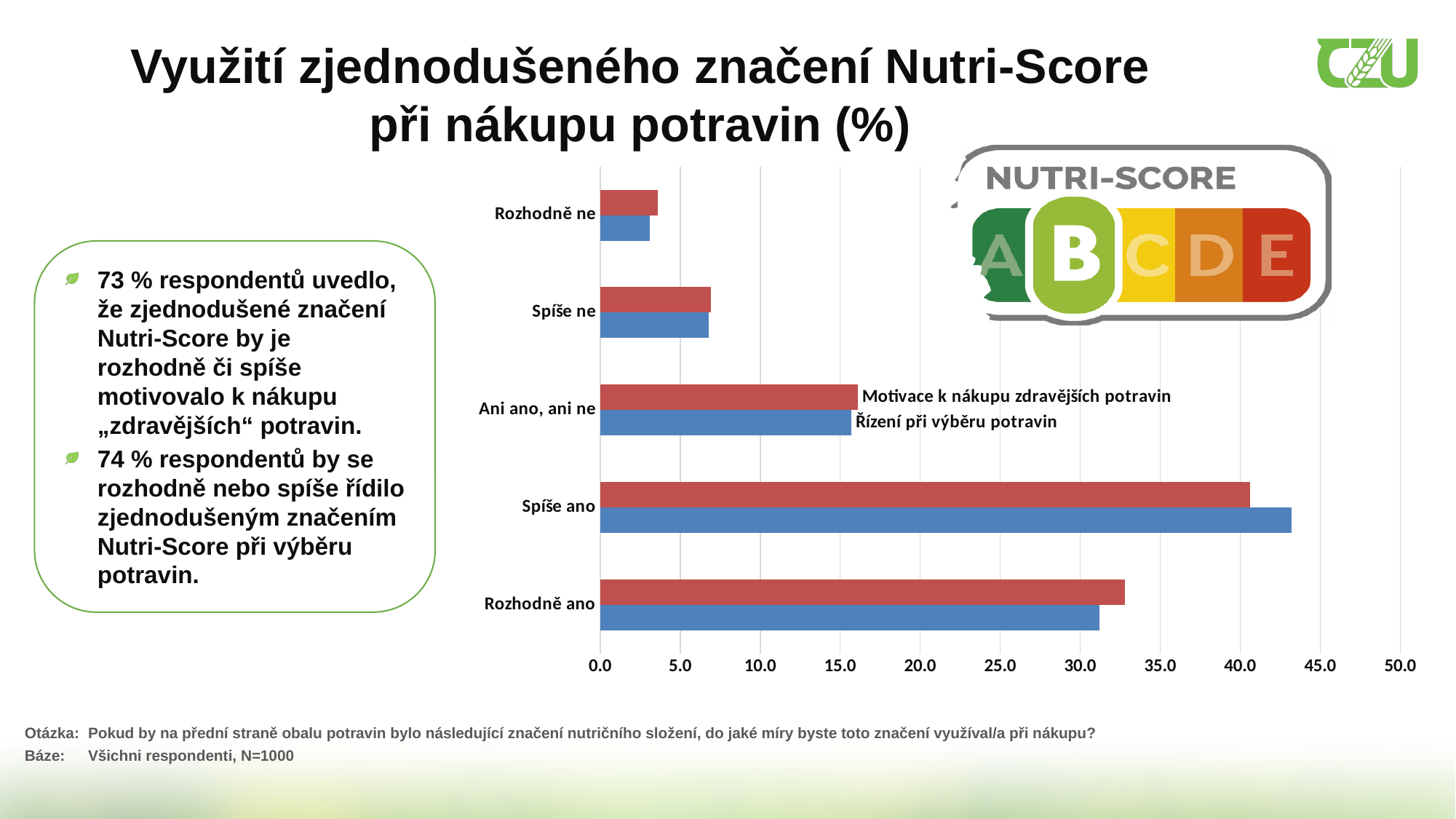
Is the value for "Ani ano, ani ne" in the series "Řízení při výběru potravin" greater or less than 20.0? less What kind of chart is shown on the slide? bar chart Is the value for "Rozhodně ano" in the series "Motivace k nákupu zdravějších potravin" greater or less than 30.0? greater How many categories are shown on the chart? 5 For the category "Spíše ano", which series has the larger value: "Motivace k nákupu zdravějších potravin" or "Řízení při výběru potravin"? Řízení při výběru potravin Which series is shown in blue on the chart? Řízení při výběru potravin Is the value for "Spíše ano" in the series "Řízení při výběru potravin" greater or less than 40.0? greater Which category has the highest value for the series "Motivace k nákupu zdravějších potravin"? Spíše ano What is the highest value shown on the chart's horizontal axis? 50.0 Which category has the lowest value for the series "Motivace k nákupu zdravějších potravin"? Rozhodně ne How many series does the chart's legend list? 2 Which category has the highest value for the series "Řízení při výběru potravin"? Spíše ano